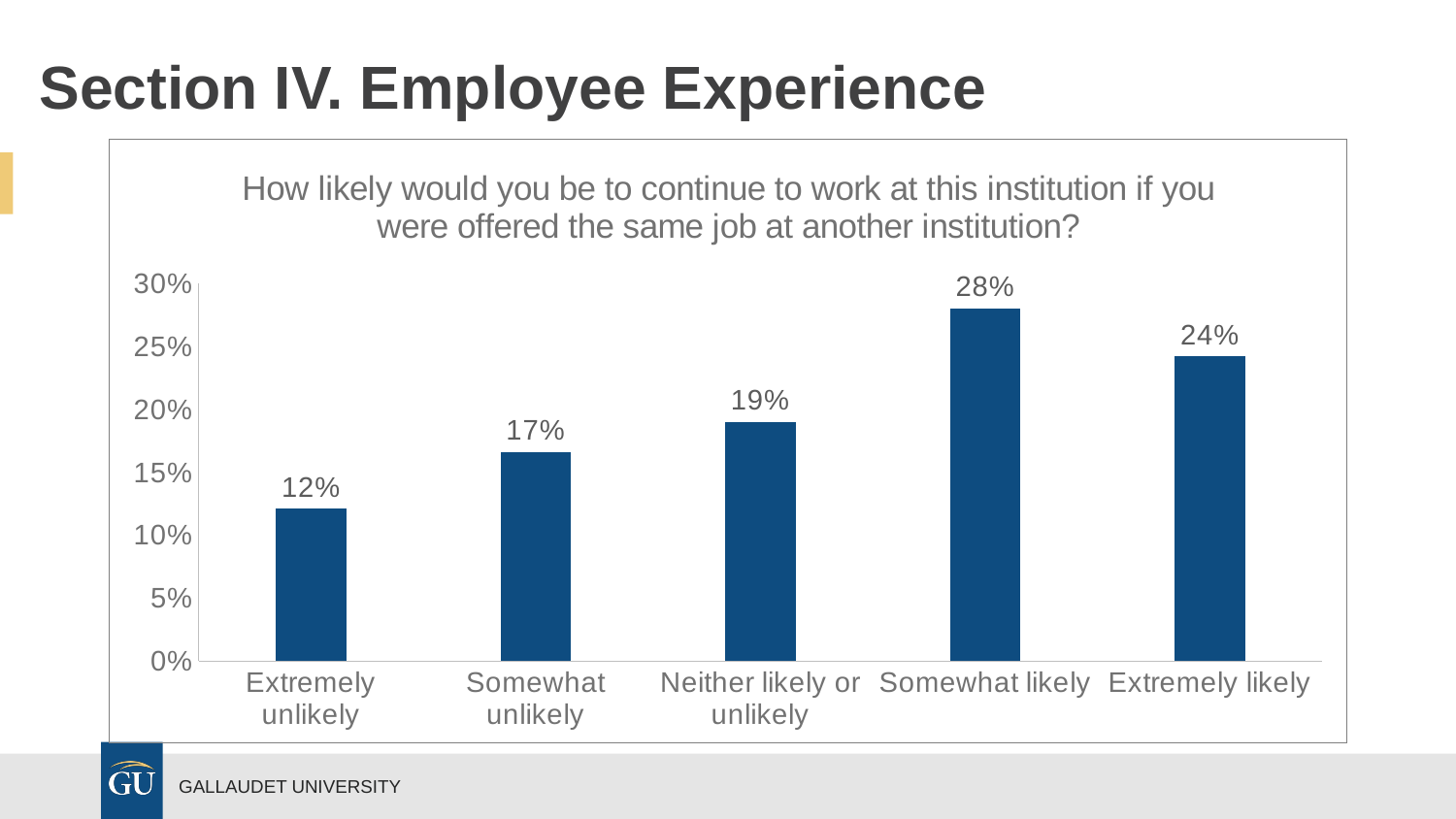
What percentage of respondents answered "Extremely unlikely"? 12% Is the value for "Somewhat likely" greater or less than 25%? greater What is the title of the chart? How likely would you be to continue to work at this institution if you were offered the same job at another institution? How many response categories are shown on the x axis? 5 Which response category has the highest value? Somewhat likely What kind of chart is shown on the slide? Bar chart What is the difference between the values for "Somewhat unlikely" and "Extremely unlikely"? 5% What is the value for "Somewhat likely"? 28% Which response category has the lowest value? Extremely unlikely What is the difference between the values for "Somewhat likely" and "Extremely likely"? 4% Which is larger, the value for "Extremely likely" or the value for "Neither likely or unlikely"? Extremely likely What is the value for "Neither likely or unlikely"? 19%